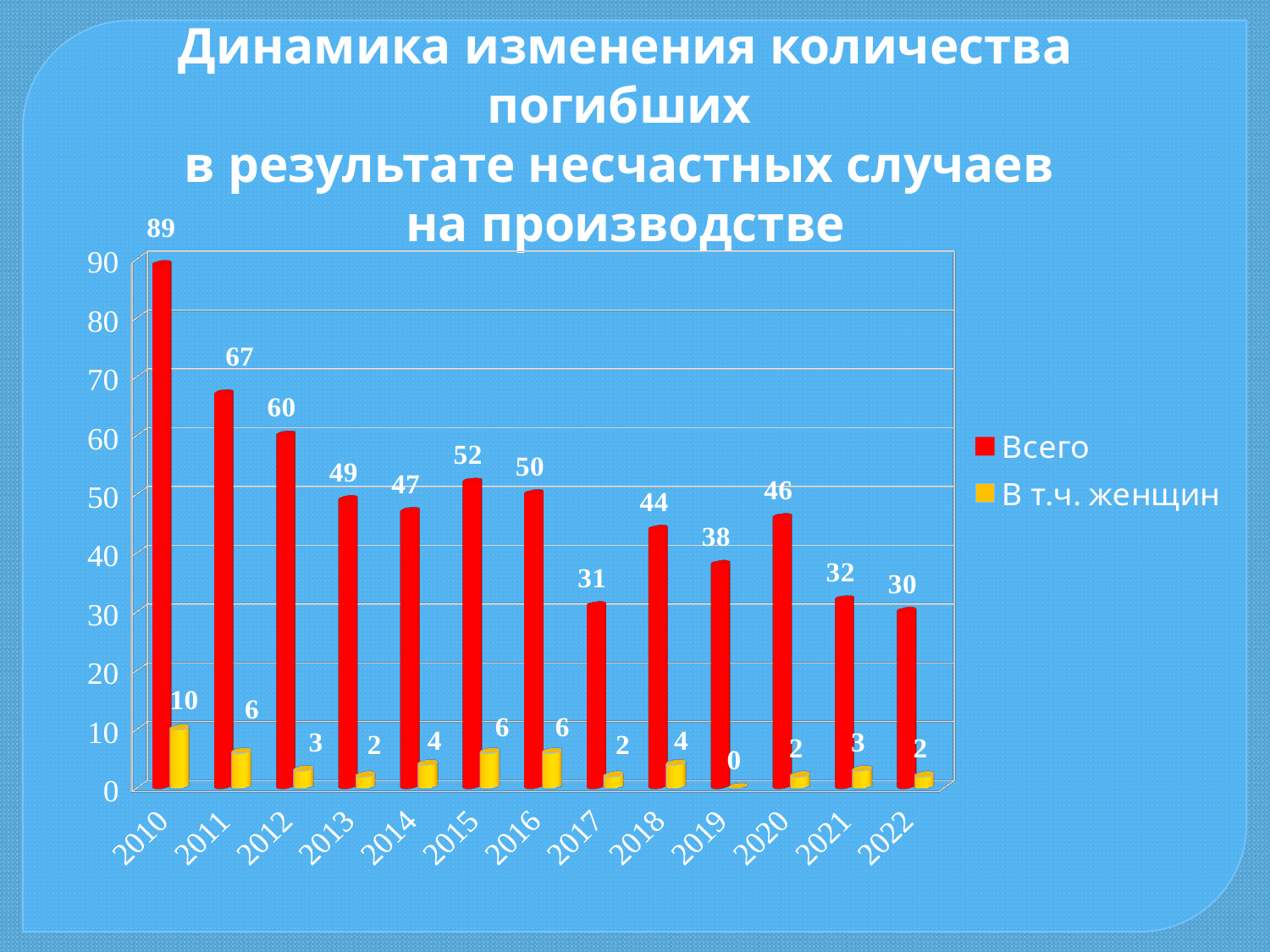
What is the value of "В т.ч. женщин" for 2015? 6 How many years are shown on the x axis? 13 What is the value of "Всего" for 2010? 89 What kind of chart is shown on the slide? bar chart Which is larger, the "Всего" value for 2015 or for 2016? 2015 What is the difference between the "Всего" values for 2010 and 2011? 22 Is the value of "Всего" for 2017 greater or less than 40? less Which colour represents the "В т.ч. женщин" series? yellow How many series does the legend list? 2 Which year has the lowest value for "В т.ч. женщин"? 2019 Which year has the highest value for "Всего"? 2010 What is the value of "Всего" for 2019? 38